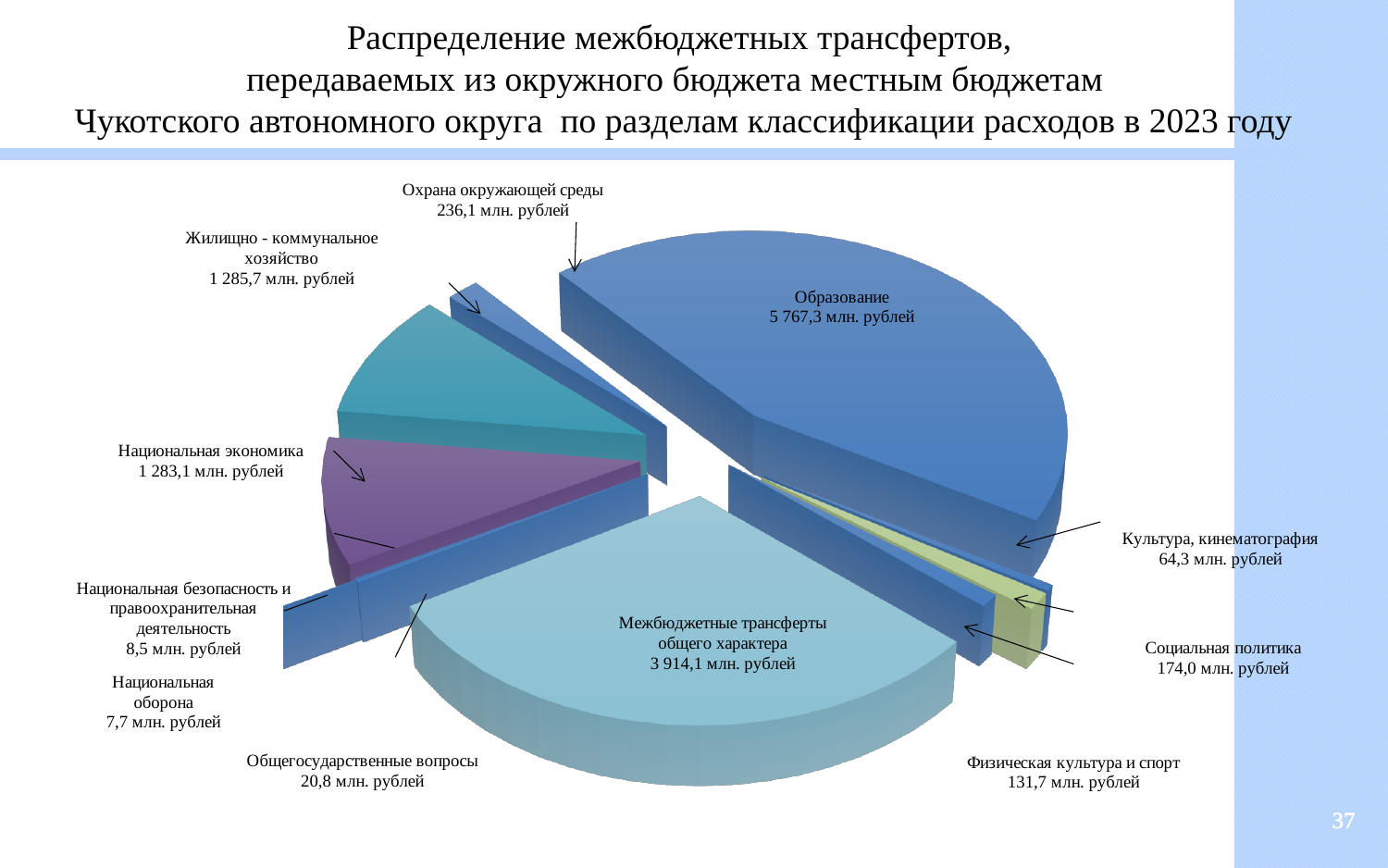
What kind of chart is shown on the slide? Pie chart What is the value for Межбюджетные трансферты общего характера? 3 914,1 млн. рублей Which is larger: the value for Социальная политика or for Физическая культура и спорт? Социальная политика What is the value for Охрана окружающей среды? 236,1 млн. рублей Which year does the chart title say the distribution of interbudgetary transfers refers to? 2023 Which category has the largest value in the pie chart? Образование Which category has the smallest value in the pie chart? Национальная оборона What is the value for Образование? 5 767,3 млн. рублей What is the difference between the values for Образование and Межбюджетные трансферты общего характера? 1 853,2 млн. рублей What is the value for Социальная политика? 174,0 млн. рублей What is the difference between the values for Жилищно-коммунальное хозяйство and Национальная экономика? 2,6 млн. рублей How many categories (slices) does the pie chart show? 11